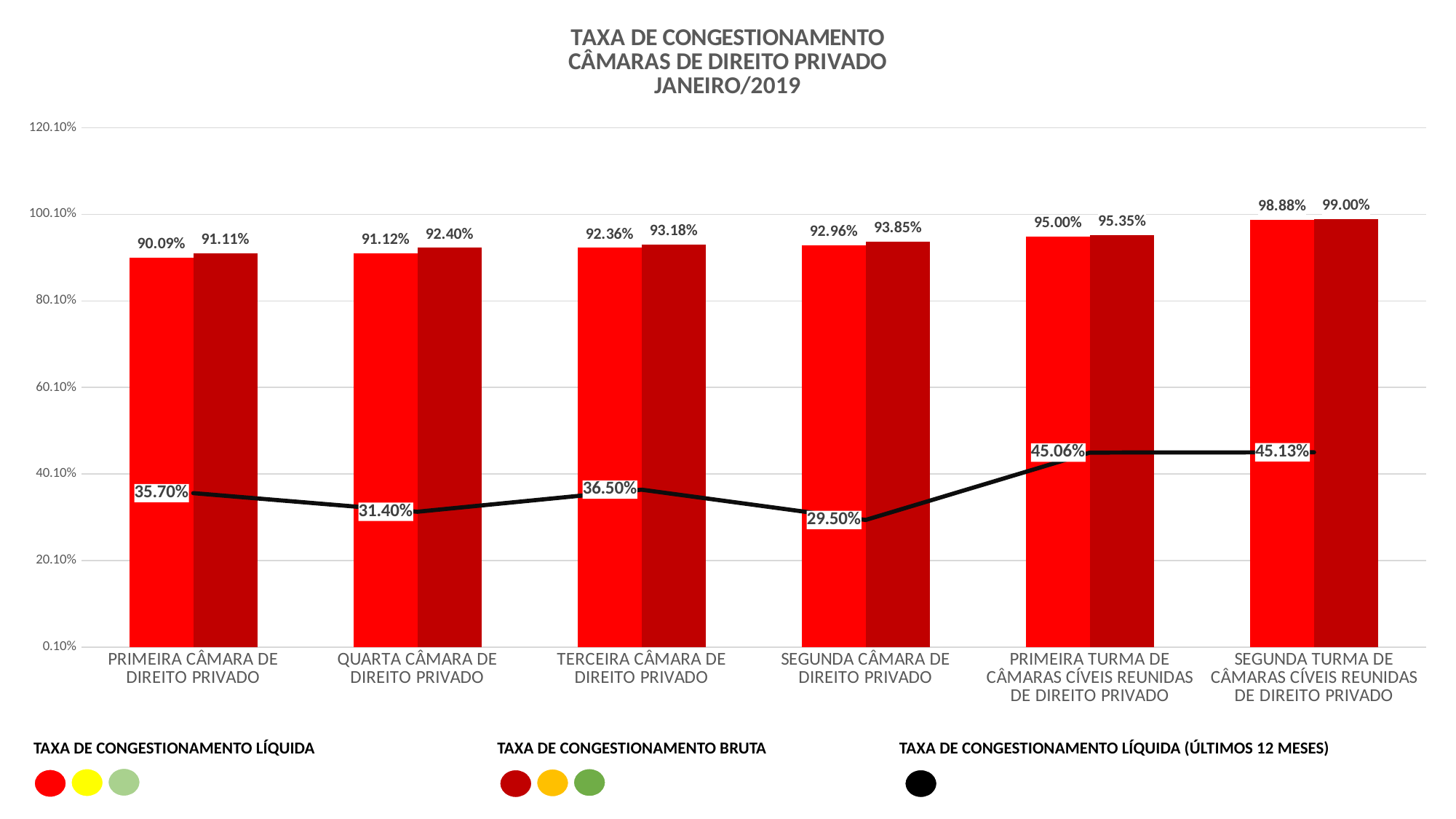
Which category has the highest Taxa de Congestionamento Bruta? Segunda Turma de Câmaras Cíveis Reunidas de Direito Privado Which is larger: the Taxa de Congestionamento Líquida (Últimos 12 Meses) for Primeira Câmara de Direito Privado or for Terceira Câmara de Direito Privado? Terceira Câmara de Direito Privado Which category has the lowest Taxa de Congestionamento Líquida (Últimos 12 Meses)? Segunda Câmara de Direito Privado What is the Taxa de Congestionamento Líquida for Primeira Câmara de Direito Privado? 90.09% What kind of chart is this? Combined bar and line chart What is the Taxa de Congestionamento Líquida (Últimos 12 Meses) for Quarta Câmara de Direito Privado? 31.40% Is the Taxa de Congestionamento Líquida (Últimos 12 Meses) for Primeira Turma de Câmaras Cíveis Reunidas de Direito Privado greater or less than 40.10%? greater What is the difference between the Taxa de Congestionamento Bruta and the Taxa de Congestionamento Líquida for Terceira Câmara de Direito Privado? 0.82% What is the title of the chart? Taxa de Congestionamento Câmaras de Direito Privado Janeiro/2019 How many categories are shown on the x axis? 6 How many series does the legend list? 3 What is the Taxa de Congestionamento Bruta for Segunda Turma de Câmaras Cíveis Reunidas de Direito Privado? 99.00%